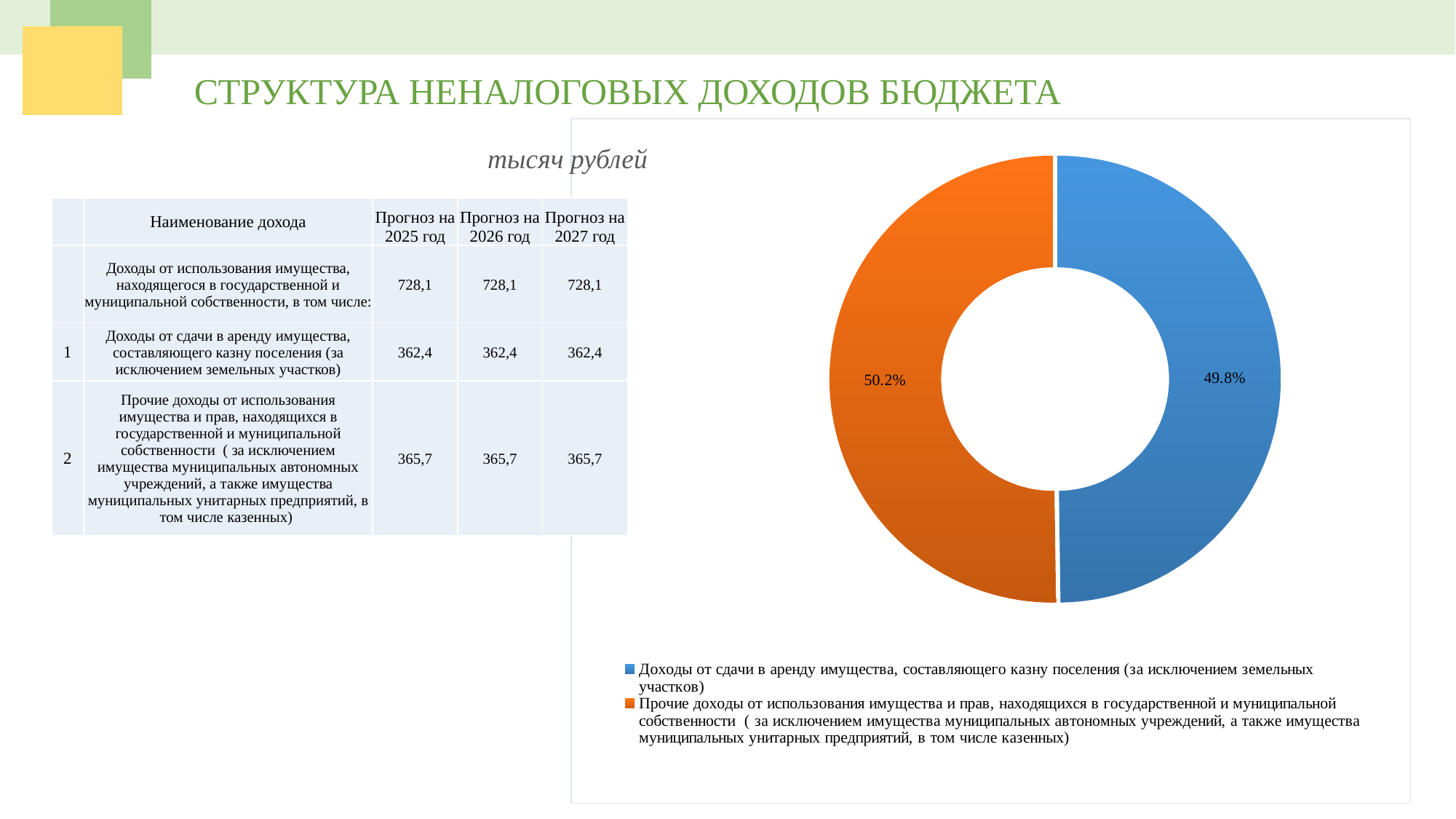
Which slice of the doughnut chart has the smaller share according to the printed labels? Доходы от сдачи в аренду имущества, составляющего казну поселения (49.8%) Is the share of the blue slice in the doughnut chart greater or less than 50%? less Which slice of the doughnut chart has the larger share according to the printed labels? Прочие доходы от использования имущества и прав (50.2%) Is the share of the orange slice in the doughnut chart greater or less than 50%? greater What share of the doughnut chart is labelled for the orange slice (Прочие доходы от использования имущества и прав)? 50.2% What is the title of the slide containing the doughnut chart? СТРУКТУРА НЕНАЛОГОВЫХ ДОХОДОВ БЮДЖЕТА What colour represents 'Доходы от сдачи в аренду имущества, составляющего казну поселения' in the doughnut chart? Blue What share of the doughnut chart is labelled for the blue slice (Доходы от сдачи в аренду имущества, составляющего казну поселения)? 49.8% What kind of chart is shown on the slide? Doughnut (pie) chart What is the difference in percentage points between the two slices of the doughnut chart? 0.4 percentage points How many entries does the legend of the doughnut chart list? 2 How many slices does the doughnut chart have? 2